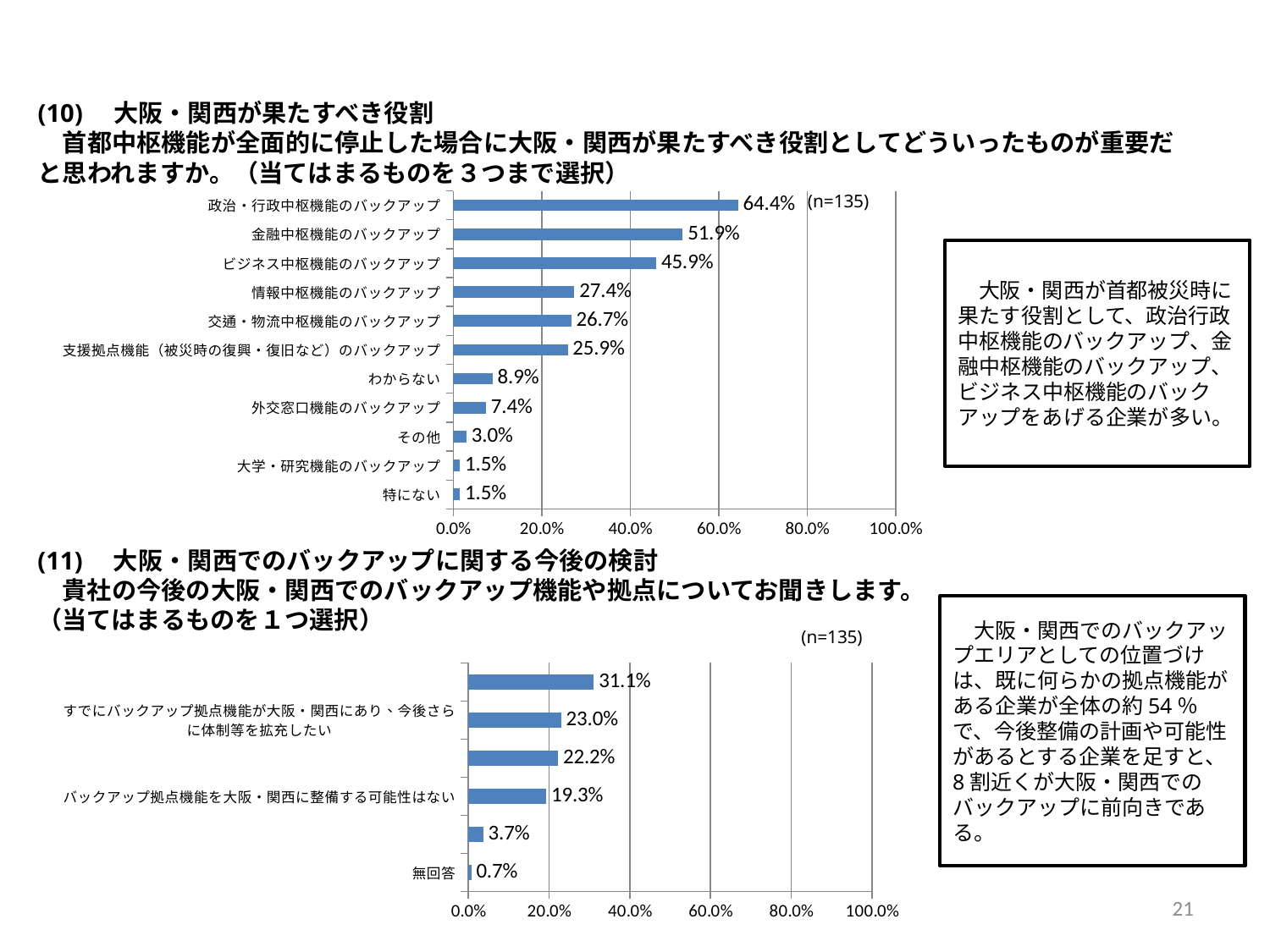
In the top chart (10), how many categories are plotted? 11 In the top chart (10), what is the value for 政治・行政中枢機能のバックアップ? 64.4% In the top chart (10), what is the value for 交通・物流中枢機能のバックアップ? 26.7% What kind of chart is the top chart (10)? bar chart In the bottom chart (11), what is the value for バックアップ拠点機能を大阪・関西に整備する可能性はない? 19.3% In the top chart (10), is the value for 情報中枢機能のバックアップ greater or less than 20.0%? greater In the top chart (10), what is the difference between 金融中枢機能のバックアップ and ビジネス中枢機能のバックアップ? 6.0% In the bottom chart (11), what is the value for すでにバックアップ拠点機能が大阪・関西にあり、今後さらに体制等を拡充したい? 23.0% In the bottom chart (11), how many bars are plotted? 6 In the top chart (10), which is larger: わからない or 外交窓口機能のバックアップ? わからない In the bottom chart (11), which category has the lowest value? 無回答 In the top chart (10), which category has the highest value? 政治・行政中枢機能のバックアップ